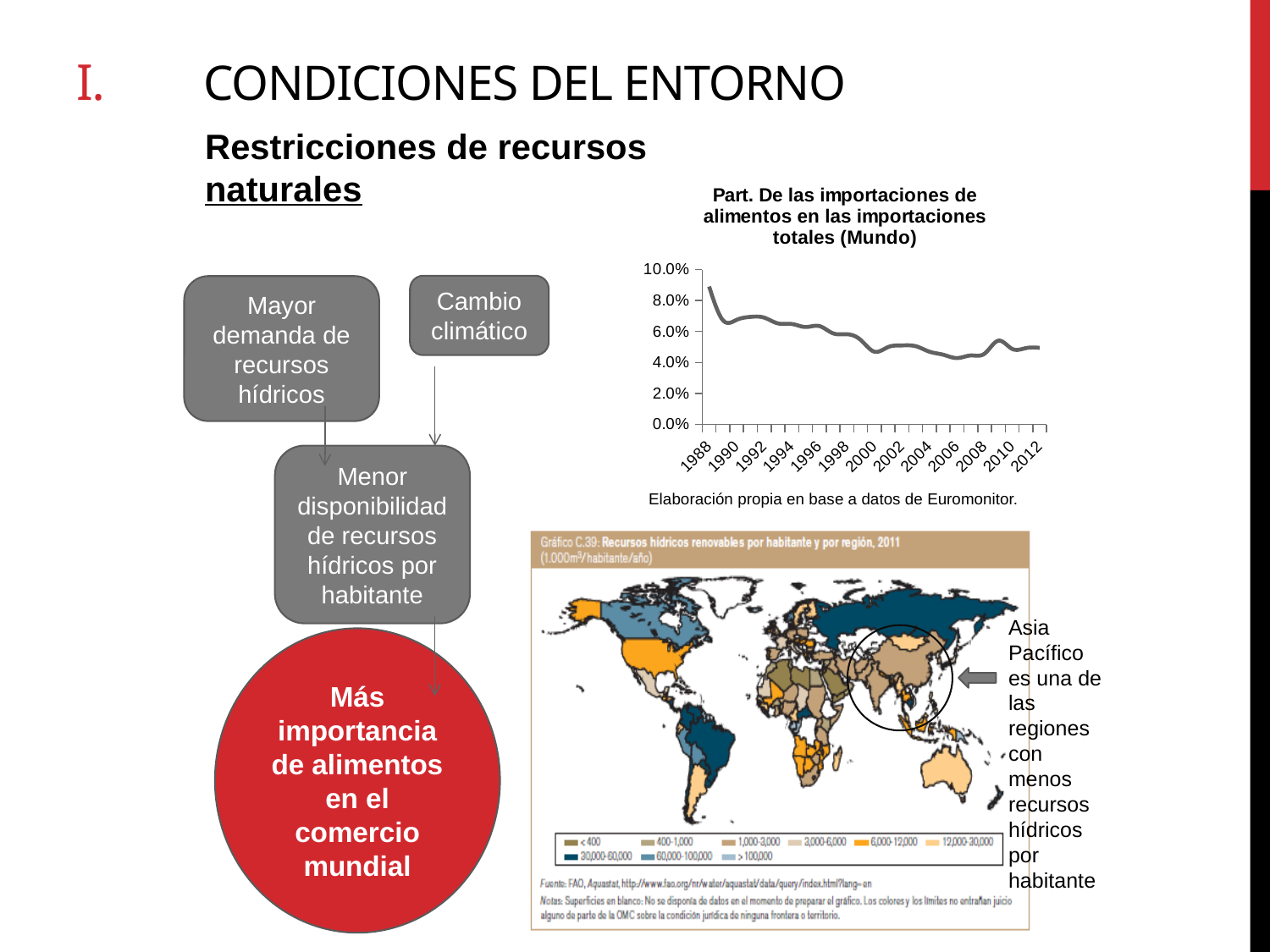
What is the first year shown on the x axis of the chart 'Part. De las importaciones de alimentos en las importaciones totales (Mundo)'? 1988 What is the highest value shown on the y axis of the chart 'Part. De las importaciones de alimentos en las importaciones totales (Mundo)'? 10.0% How many year labels are shown on the x axis of the chart 'Part. De las importaciones de alimentos en las importaciones totales (Mundo)'? 13 What kind of chart is 'Part. De las importaciones de alimentos en las importaciones totales (Mundo)'? line chart In the chart 'Part. De las importaciones de alimentos en las importaciones totales (Mundo)', is the value for 2012 greater or less than 6.0%? less In the chart 'Part. De las importaciones de alimentos en las importaciones totales (Mundo)', which year has the highest value? 1988 In the chart 'Part. De las importaciones de alimentos en las importaciones totales (Mundo)', is the value for 1988 greater or less than 8.0%? greater In the chart 'Part. De las importaciones de alimentos en las importaciones totales (Mundo)', is the value for 2006 greater or less than 6.0%? less In the chart 'Part. De las importaciones de alimentos en las importaciones totales (Mundo)', do the values generally rise or fall from 1988 to 2012? fall In the chart 'Part. De las importaciones de alimentos en las importaciones totales (Mundo)', which is larger, the value for 1988 or the value for 2012? 1988